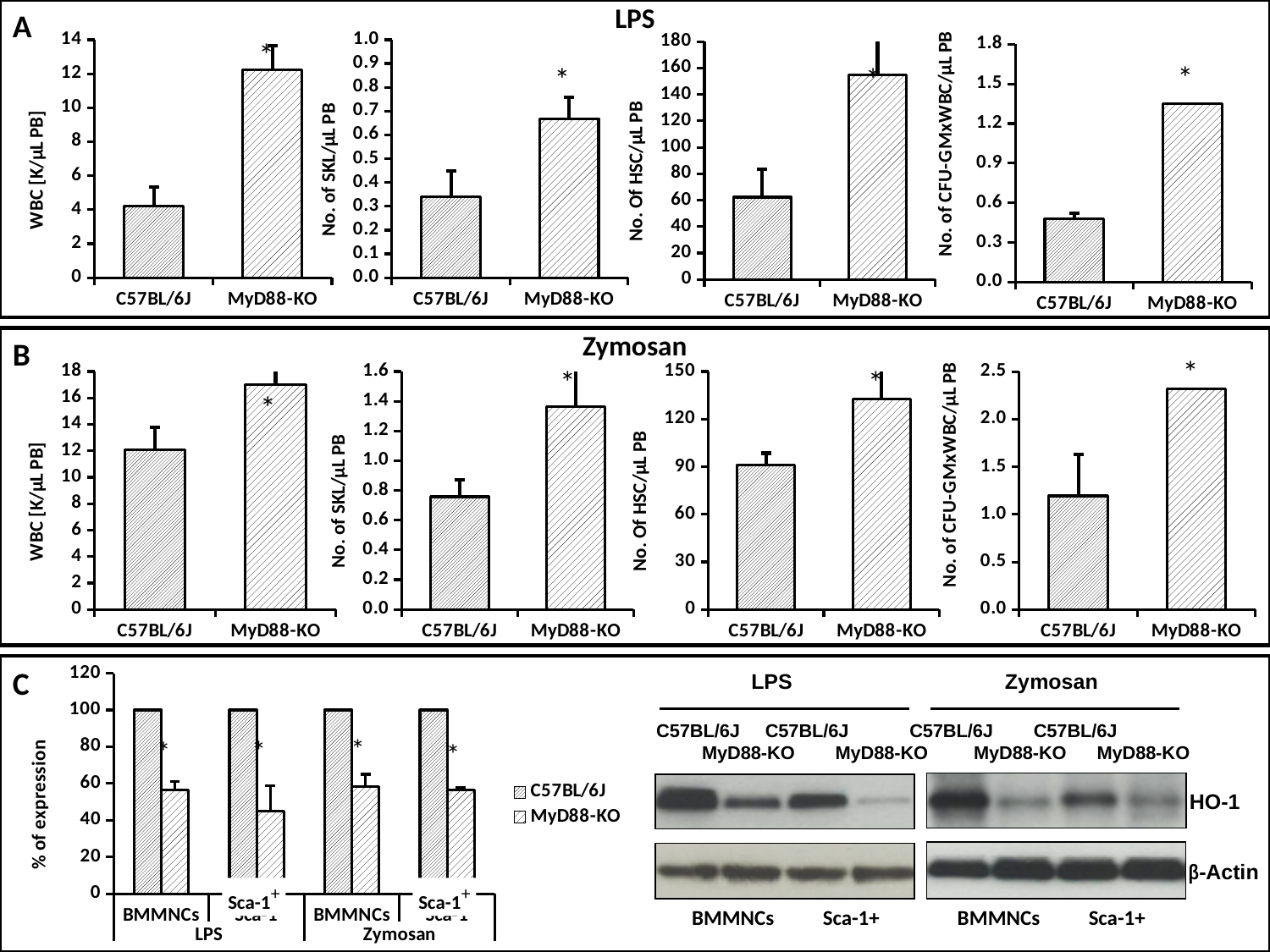
In panel B (Zymosan), No. of SKL/µL PB chart, which group has the lowest value? C57BL/6J In panel B (Zymosan), No. of CFU-GMxWBC/µL PB chart, is the value for MyD88-KO greater or less than 2.0? greater In panel B (Zymosan), No. Of HSC/µL PB chart, is the value for MyD88-KO greater or less than 120? greater In panel A (LPS), No. Of HSC/µL PB chart, is the value for MyD88-KO greater or less than 140? greater In panel C, the % of expression chart, what is the value for C57BL/6J in the LPS BMMNCs group? 100 In panel A (LPS), No. of SKL/µL PB chart, which group has the higher value, C57BL/6J or MyD88-KO? MyD88-KO What type of chart is used in panel C for % of expression? Bar chart In panel C, the % of expression chart, how many series does the legend list? 2